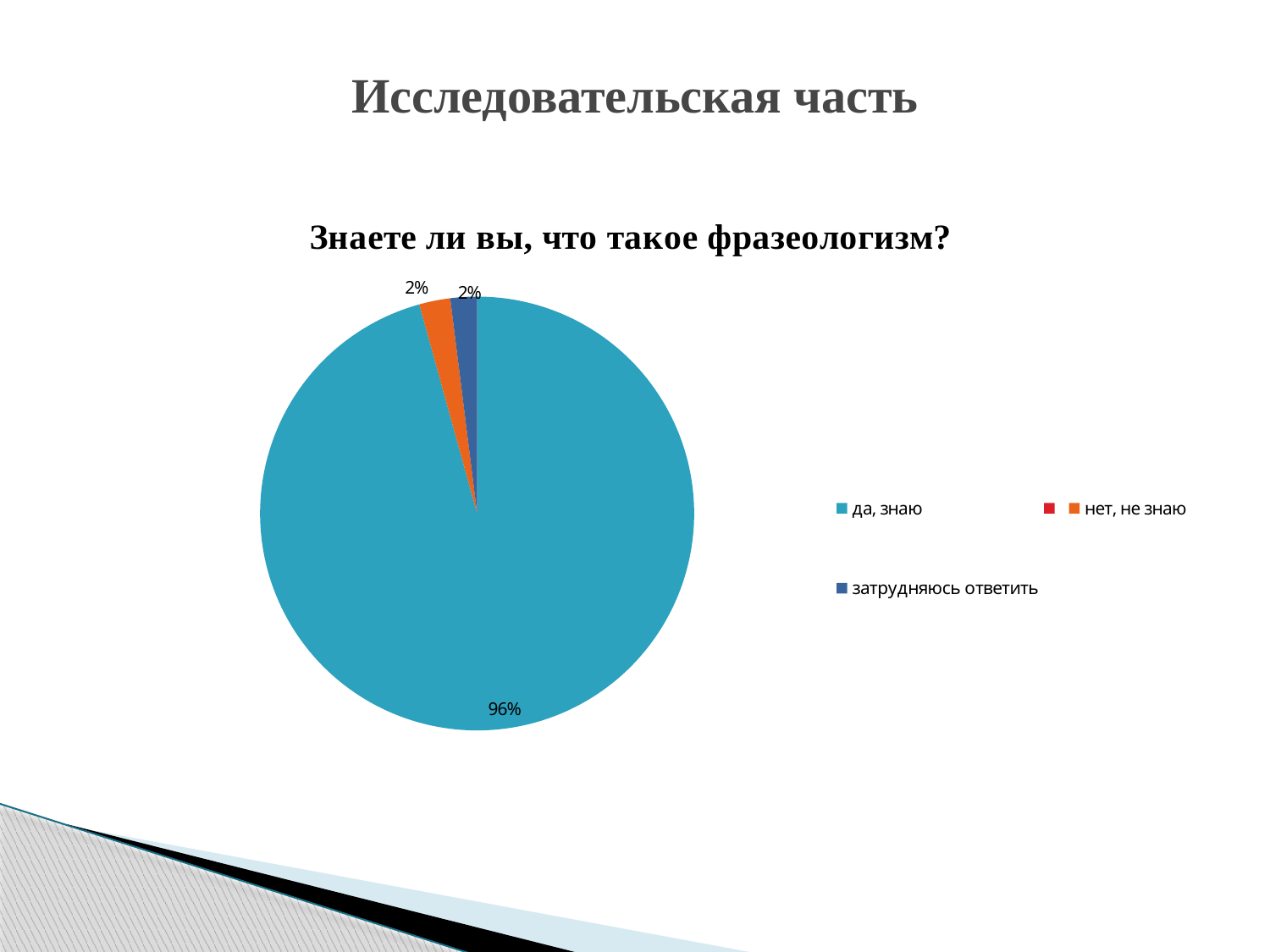
What type of chart is shown on the slide? pie chart What is the title of the chart? Знаете ли вы, что такое фразеологизм? Which answer has the largest share of the pie? да, знаю What colour is the slice for "да, знаю"? blue How many categories does the pie chart show? 3 What is the difference in percentage points between "да, знаю" and "нет, не знаю"? 94 What percentage of respondents answered "затрудняюсь ответить"? 2% What is the combined share of "нет, не знаю" and "затрудняюсь ответить"? 4% Which is larger: the share for "да, знаю" or the share for "затрудняюсь ответить"? да, знаю What percentage of respondents answered "нет, не знаю"? 2% What percentage of respondents answered "да, знаю"? 96%